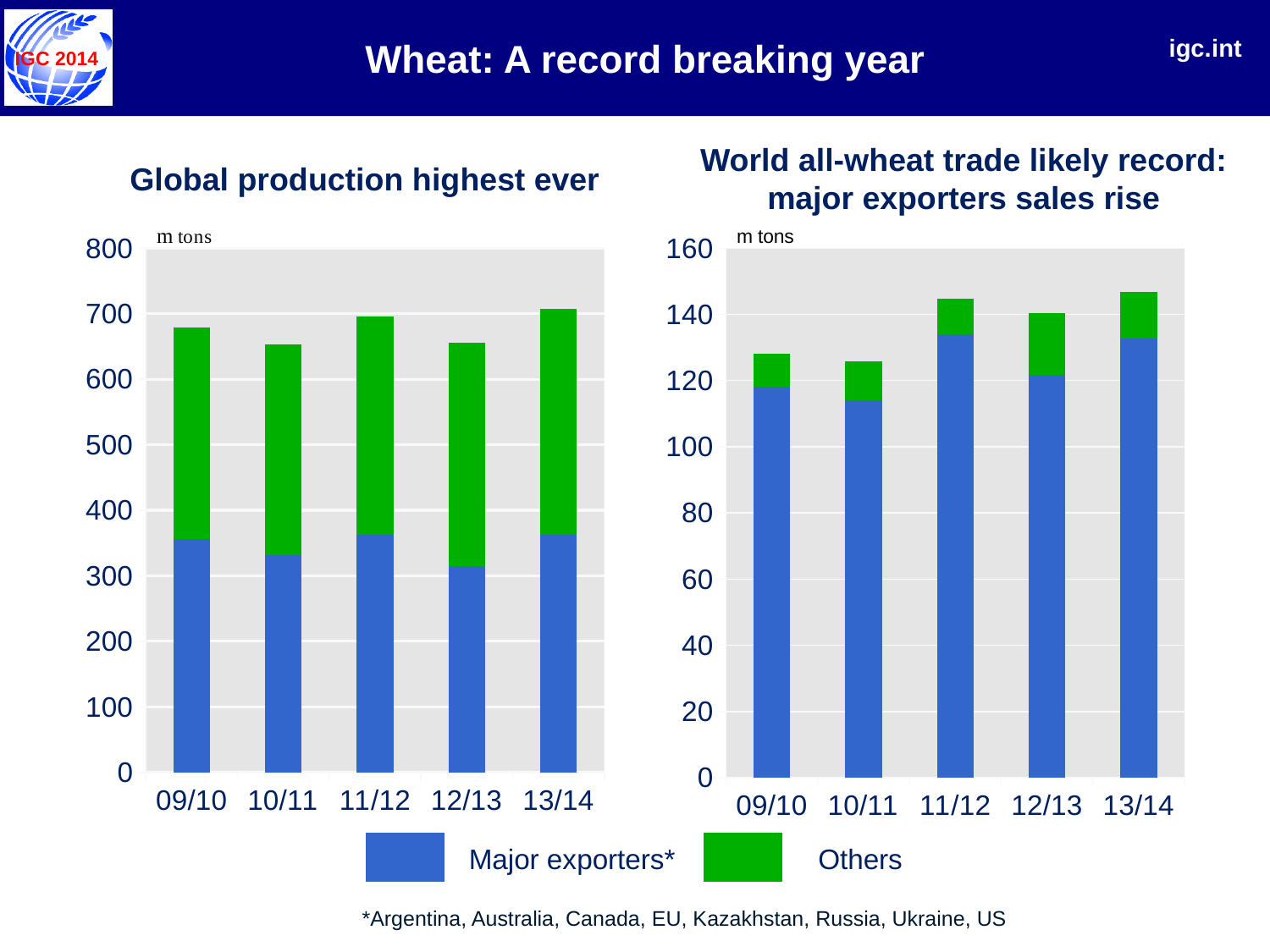
What kind of chart is the 'Global production highest ever' chart? stacked bar chart How many seasons are shown on the x axis of the 'World all-wheat trade likely record' chart? 5 In the 'Global production highest ever' chart, which season has the lowest value for Major exporters*? 12/13 In the 'Global production highest ever' chart, is the total for 13/14 greater or less than 700? greater In the 'World all-wheat trade likely record' chart, which total is larger, 11/12 or 12/13? 11/12 Which colour represents Others in the legend? green In the 'World all-wheat trade likely record' chart, is the Major exporters* value for 09/10 greater or less than 120? less In the 'Global production highest ever' chart, is the total for 10/11 greater or less than 700? less What unit is shown on the y axis of both charts? m tons In the 'Global production highest ever' chart, which season has the highest total production? 13/14 How many series does the shared legend list for the charts? 2